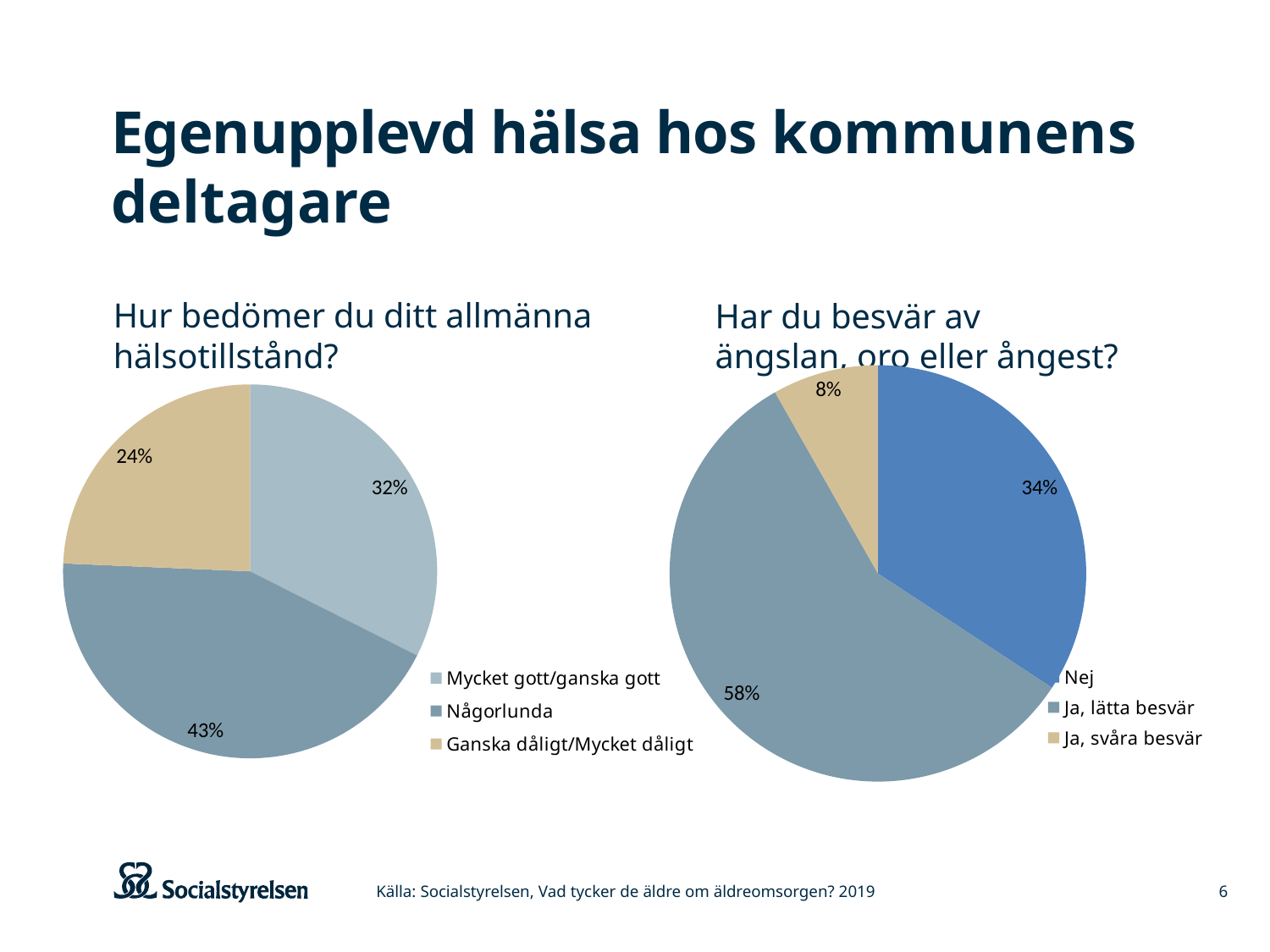
In the left chart 'Hur bedömer du ditt allmänna hälsotillstånd?', what share of respondents answered 'Någorlunda'? 43% In the right chart 'Har du besvär av ängslan, oro eller ångest?', which is larger: 'Nej' or 'Ja, svåra besvär'? Nej How many categories does the legend of the right chart 'Har du besvär av ängslan, oro eller ångest?' list? 3 In the right chart 'Har du besvär av ängslan, oro eller ångest?', which category has the largest slice? Ja, lätta besvär In the right chart 'Har du besvär av ängslan, oro eller ångest?', what share of respondents answered 'Nej'? 34% In the right chart 'Har du besvär av ängslan, oro eller ångest?', what share of respondents answered 'Ja, svåra besvär'? 8% In the left chart 'Hur bedömer du ditt allmänna hälsotillstånd?', which category has the smallest slice? Ganska dåligt/Mycket dåligt In the left chart 'Hur bedömer du ditt allmänna hälsotillstånd?', how many percentage points larger is 'Någorlunda' than 'Ganska dåligt/Mycket dåligt'? 19 percentage points In the right chart 'Har du besvär av ängslan, oro eller ångest?', what share of respondents answered 'Ja, lätta besvär'? 58% What type of chart is the left chart 'Hur bedömer du ditt allmänna hälsotillstånd?'? Pie chart In the left chart 'Hur bedömer du ditt allmänna hälsotillstånd?', which category has the largest slice? Någorlunda In the left chart 'Hur bedömer du ditt allmänna hälsotillstånd?', what share of respondents answered 'Mycket gott/ganska gott'? 32%